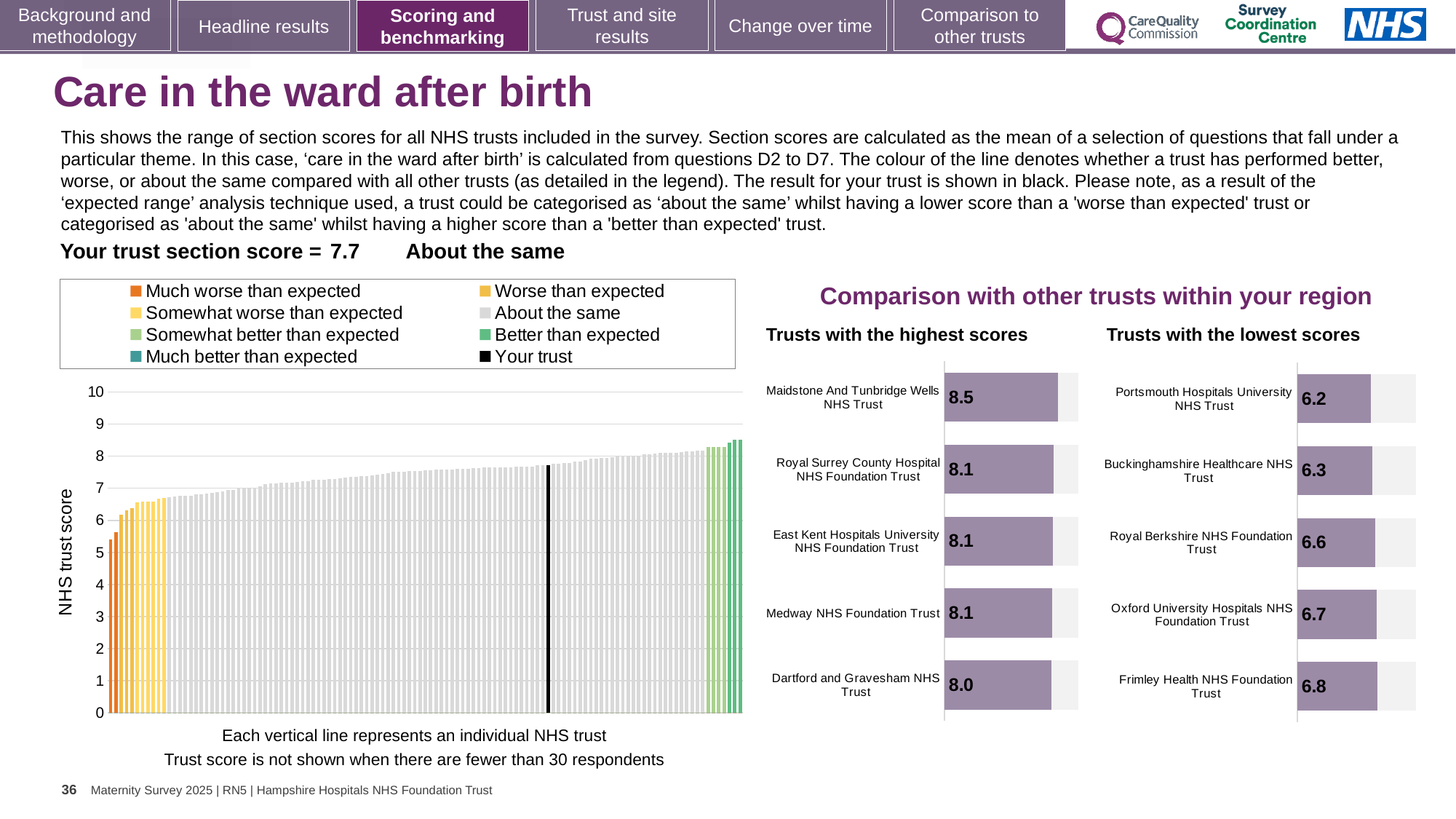
What kind of chart is the NHS trust score chart on the left? Bar chart In the 'Trusts with the lowest scores' chart, which has the higher score: Royal Berkshire NHS Foundation Trust or Oxford University Hospitals NHS Foundation Trust? Oxford University Hospitals NHS Foundation Trust In the 'Trusts with the lowest scores' chart, what is the score for Royal Berkshire NHS Foundation Trust? 6.6 In the 'Trusts with the lowest scores' chart, which trust has the lowest score? Portsmouth Hospitals University NHS Trust In the 'Trusts with the highest scores' chart, what is the difference between the scores of Maidstone And Tunbridge Wells NHS Trust and Dartford and Gravesham NHS Trust? 0.5 How many trusts are shown in the 'Trusts with the highest scores' chart? 5 In the 'Trusts with the highest scores' chart, what is the score for Maidstone And Tunbridge Wells NHS Trust? 8.5 In the 'Trusts with the lowest scores' chart, which trust has the highest score? Frimley Health NHS Foundation Trust In the 'Trusts with the lowest scores' chart, what is the difference between the scores of Frimley Health NHS Foundation Trust and Portsmouth Hospitals University NHS Trust? 0.6 How many entries does the legend of the NHS trust score chart list? 8 In the 'Trusts with the highest scores' chart, which trust has the lowest score? Dartford and Gravesham NHS Trust In the NHS trust score chart on the left, do the values rise or fall from left to right? Rise